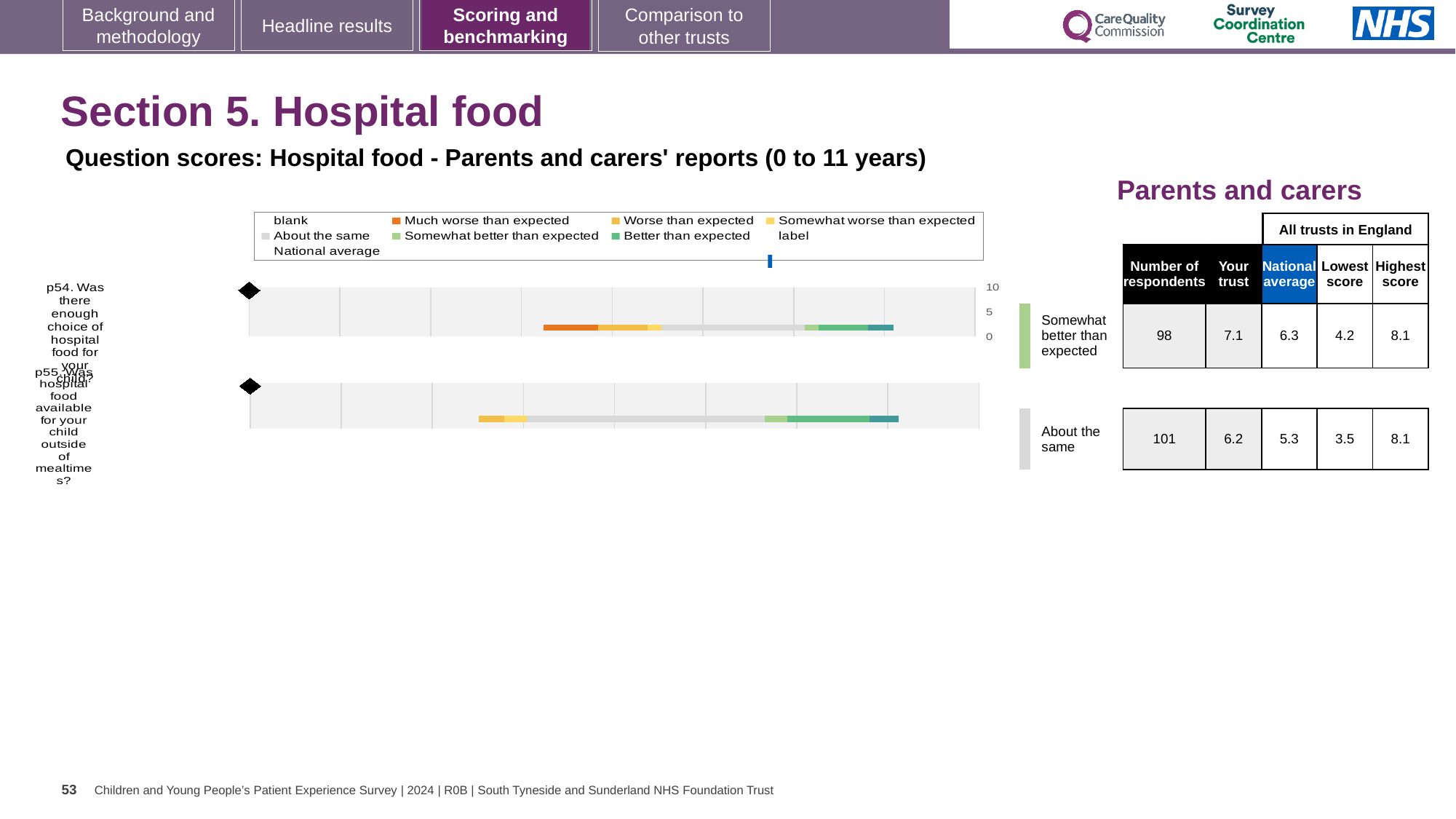
What is the trust's score for p54 (enough choice of hospital food for your child)? 7.1 Which benchmark category does the trust's result for p54 fall into? Somewhat better than expected What is the national average score for p54? 6.3 What is the trust's score for p55 (hospital food available outside of mealtimes)? 6.2 What is the highest score among all trusts in England for p55? 8.1 What is the lowest score among all trusts in England for p54? 4.2 How many respondents answered p55? 101 What kind of chart is used to show the question scores for hospital food? bar chart How many questions (categories) are plotted in the hospital food chart? 2 Which question has the higher trust score, p54 or p55? p54 What is the title of the chart on the slide? Question scores: Hospital food - Parents and carers' reports (0 to 11 years) By how much does the trust's score for p54 exceed the national average for p54? 0.8